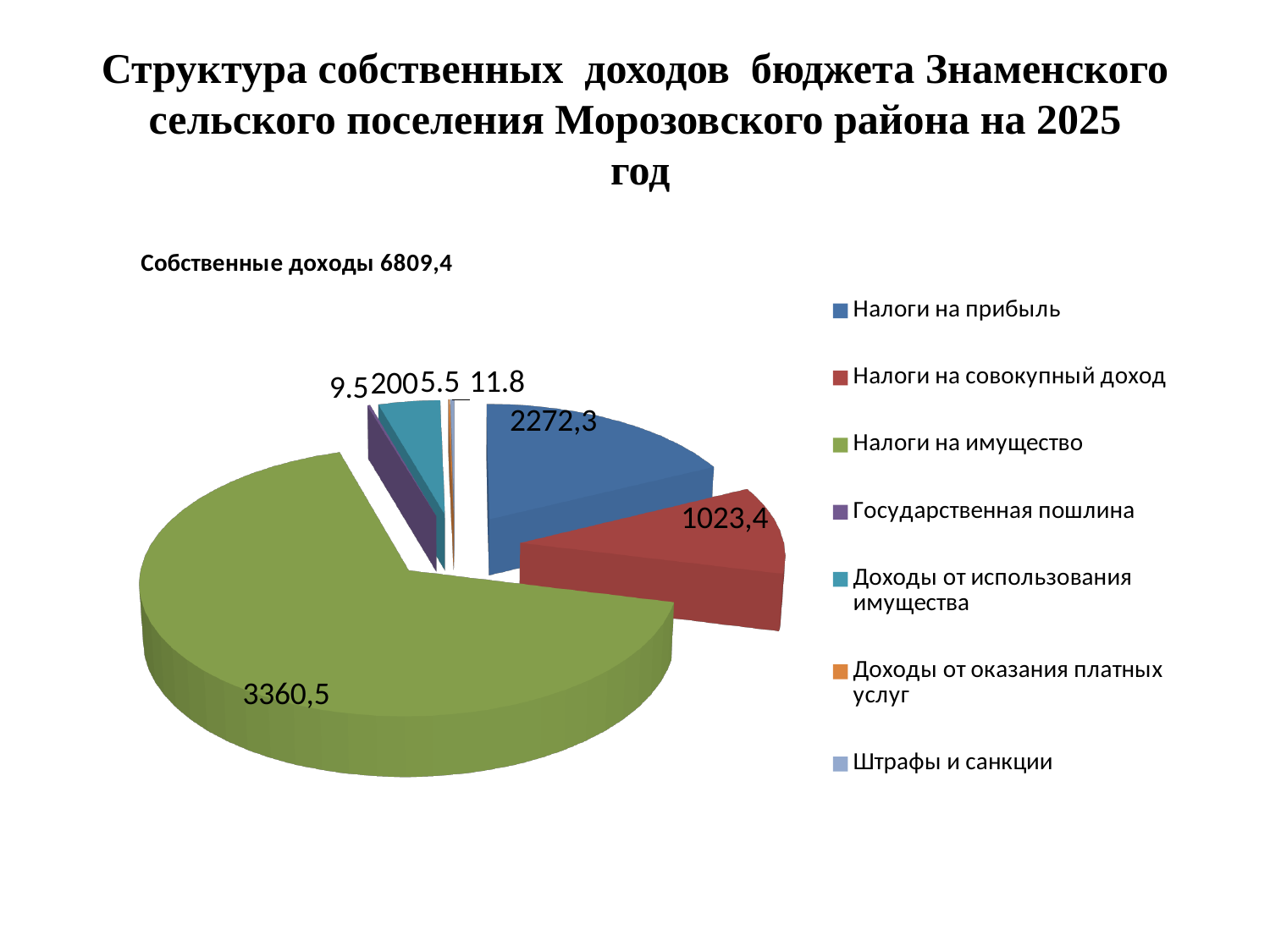
Which category has the largest slice of the pie? Налоги на имущество What total for own revenues (Собственные доходы) is printed in the chart title? 6809,4 What is the difference between the values for Налоги на имущество and Налоги на прибыль? 1088,2 What is the title of the chart? Собственные доходы 6809,4 What is the value shown for Налоги на совокупный доход? 1023,4 What is the value shown for Налоги на прибыль? 2272,3 What is the value shown for Налоги на имущество? 3360,5 How many categories does the pie chart's legend list? 7 What colour is the slice for Налоги на имущество? Green What kind of chart is shown on the slide? Pie chart What is the difference between the values for Налоги на прибыль and Налоги на совокупный доход? 1248,9 Which is larger: Налоги на прибыль or Налоги на совокупный доход? Налоги на прибыль